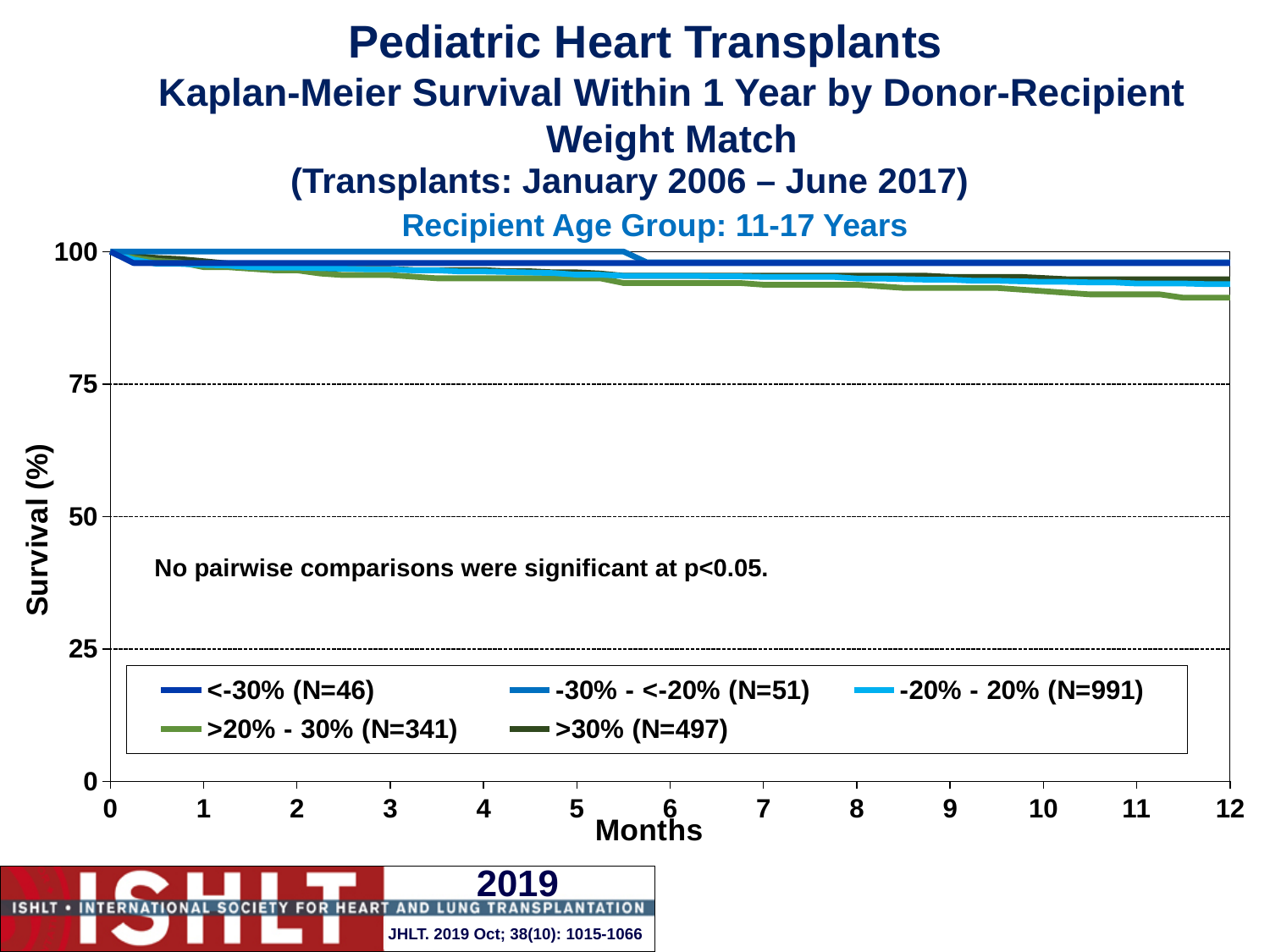
According to the legend, what is the N for the -20% - 20% weight-match group? 991 How many labelled tick marks are on the Months axis? 13 Is the survival value for the -20% - 20% group at 6 months greater or less than 50? greater How many series does the legend list? 5 Is the survival value for the >20% - 30% group at 12 months greater or less than 75? greater What kind of chart is shown on the slide? Line chart Which weight-match group has the lowest survival at 12 months? >20% - 30% (N=341) Is the survival value for the <-30% group at 12 months greater or less than 75? greater Do the survival curves rise or fall as months increase along the x axis? Fall At 12 months, which is higher: survival for the <-30% group or for the >20% - 30% group? <-30% group What is the maximum value shown on the Survival (%) axis? 100